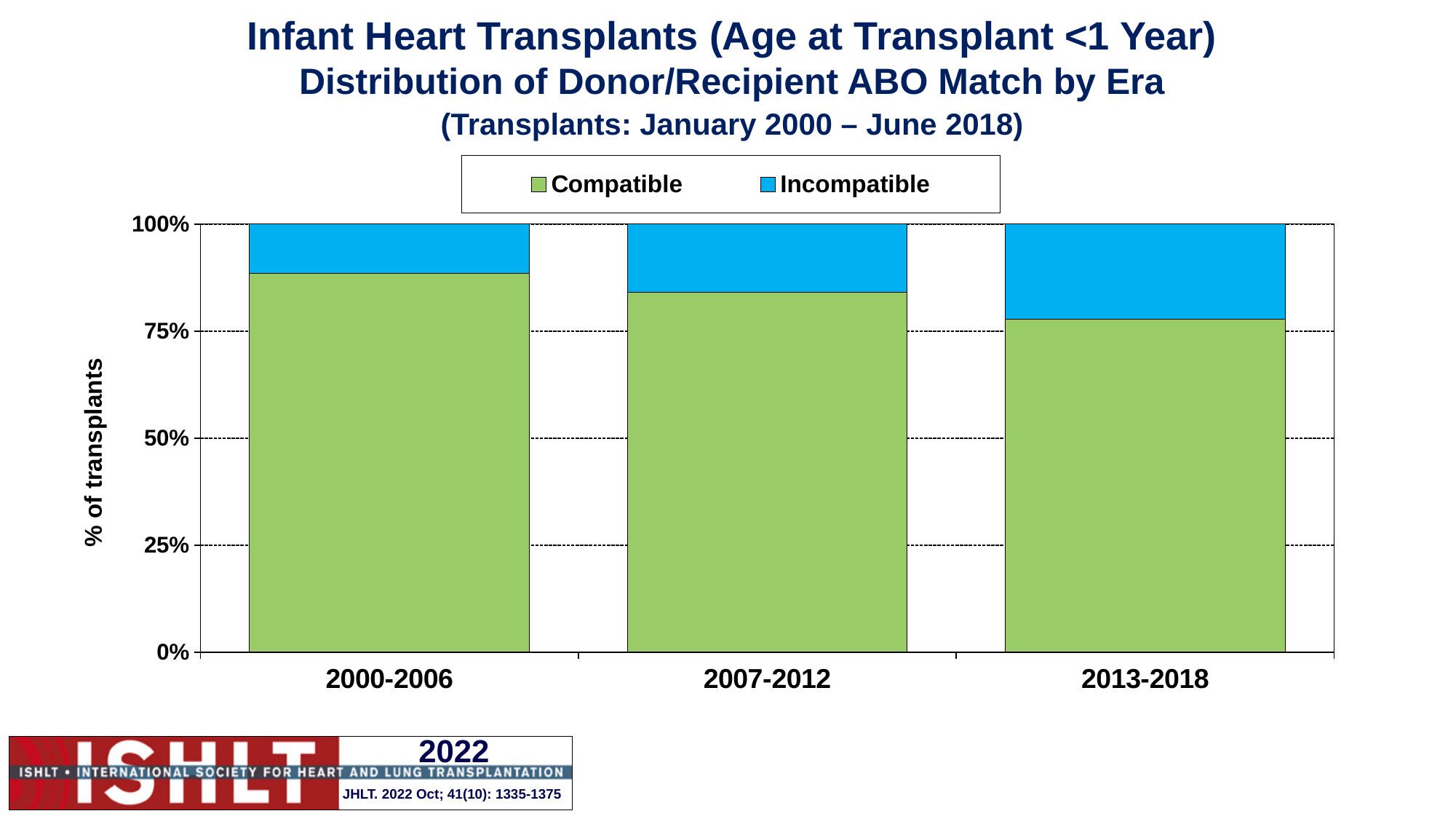
Which is larger: the Compatible share in 2007-2012 or in 2013-2018? 2007-2012 Which era has the largest share of Incompatible transplants? 2013-2018 Is the Incompatible share for 2007-2012 greater or less than 25%? less Which era has the highest share of Compatible transplants? 2000-2006 Is the Compatible share for 2000-2006 greater or less than 75%? greater Which era has the lowest share of Compatible transplants? 2013-2018 How many eras (categories) are shown on the x axis? 3 Is the Compatible share for 2013-2018 greater or less than 75%? greater Does the Compatible share rise or fall across the eras from 2000-2006 to 2013-2018? fall How many series does the legend list? 2 What kind of chart is shown on the slide? Stacked bar chart What colour represents the Incompatible series in the legend? Blue